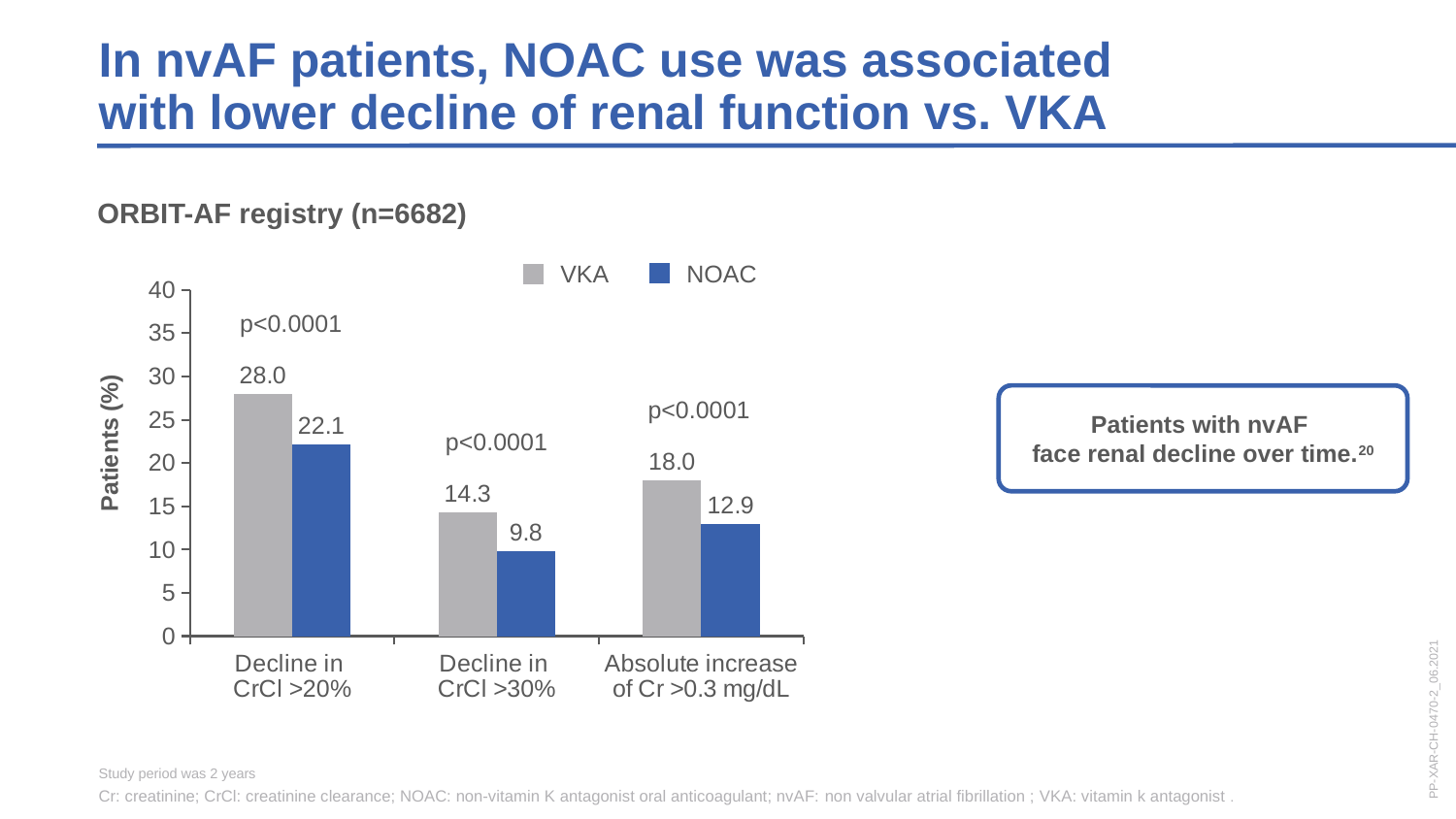
Which category has the highest VKA value? Decline in CrCl >20% What is the difference between the VKA and NOAC values in the 'Absolute increase of Cr >0.3 mg/dL' category? 5.1 Is the VKA value for 'Absolute increase of Cr >0.3 mg/dL' greater or less than 20? less How many categories are shown on the x axis? 3 What is the difference between the VKA and NOAC values in the 'Decline in CrCl >20%' category? 5.9 How many series does the legend list? 2 What is the value for NOAC in the 'Absolute increase of Cr >0.3 mg/dL' category? 12.9 What is the value for VKA in the 'Decline in CrCl >20%' category? 28.0 Which category has the lowest NOAC value? Decline in CrCl >30% What is the value for NOAC in the 'Decline in CrCl >30%' category? 9.8 What kind of chart is shown on the slide? Bar chart Which is larger in the 'Decline in CrCl >30%' category, VKA or NOAC? VKA